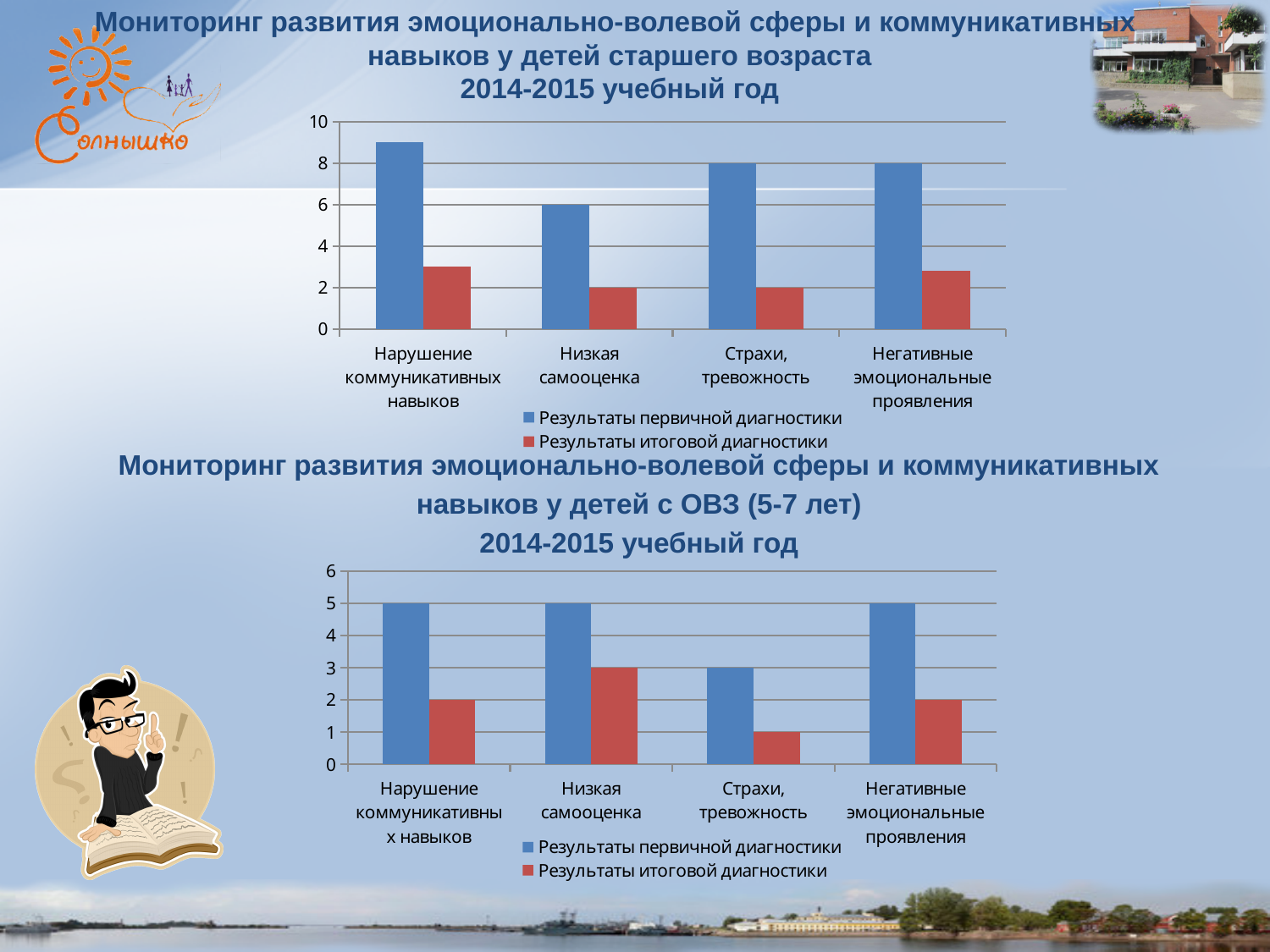
In the bottom chart (children with ОВЗ, 5-7 years), what is the value of 'Результаты итоговой диагностики' for 'Низкая самооценка'? 3 In the bottom chart (children with ОВЗ, 5-7 years), what is the value of 'Результаты первичной диагностики' for 'Страхи, тревожность'? 3 In the bottom chart (children with ОВЗ, 5-7 years), which is larger for 'Негативные эмоциональные проявления': 'Результаты первичной диагностики' or 'Результаты итоговой диагностики'? Результаты первичной диагностики In the top chart (children of senior age), which category has the lowest value for 'Результаты первичной диагностики'? Низкая самооценка In the bottom chart (children with ОВЗ, 5-7 years), what is the difference between 'Результаты первичной диагностики' and 'Результаты итоговой диагностики' for 'Нарушение коммуникативных навыков'? 3 In the top chart (children of senior age), what is the value of 'Результаты первичной диагностики' for 'Низкая самооценка'? 6 In the top chart (children of senior age), what is the value of 'Результаты итоговой диагностики' for 'Страхи, тревожность'? 2 In the bottom chart (children with ОВЗ, 5-7 years), how many categories are shown on the x axis? 4 In the top chart (children of senior age), how many series does the legend list? 2 What type of chart is the bottom chart (children with ОВЗ, 5-7 years)? bar chart In the bottom chart (children with ОВЗ, 5-7 years), which category has the lowest value for 'Результаты итоговой диагностики'? Страхи, тревожность In the top chart (children of senior age), is the value of 'Результаты первичной диагностики' for 'Нарушение коммуникативных навыков' greater or less than 8? greater